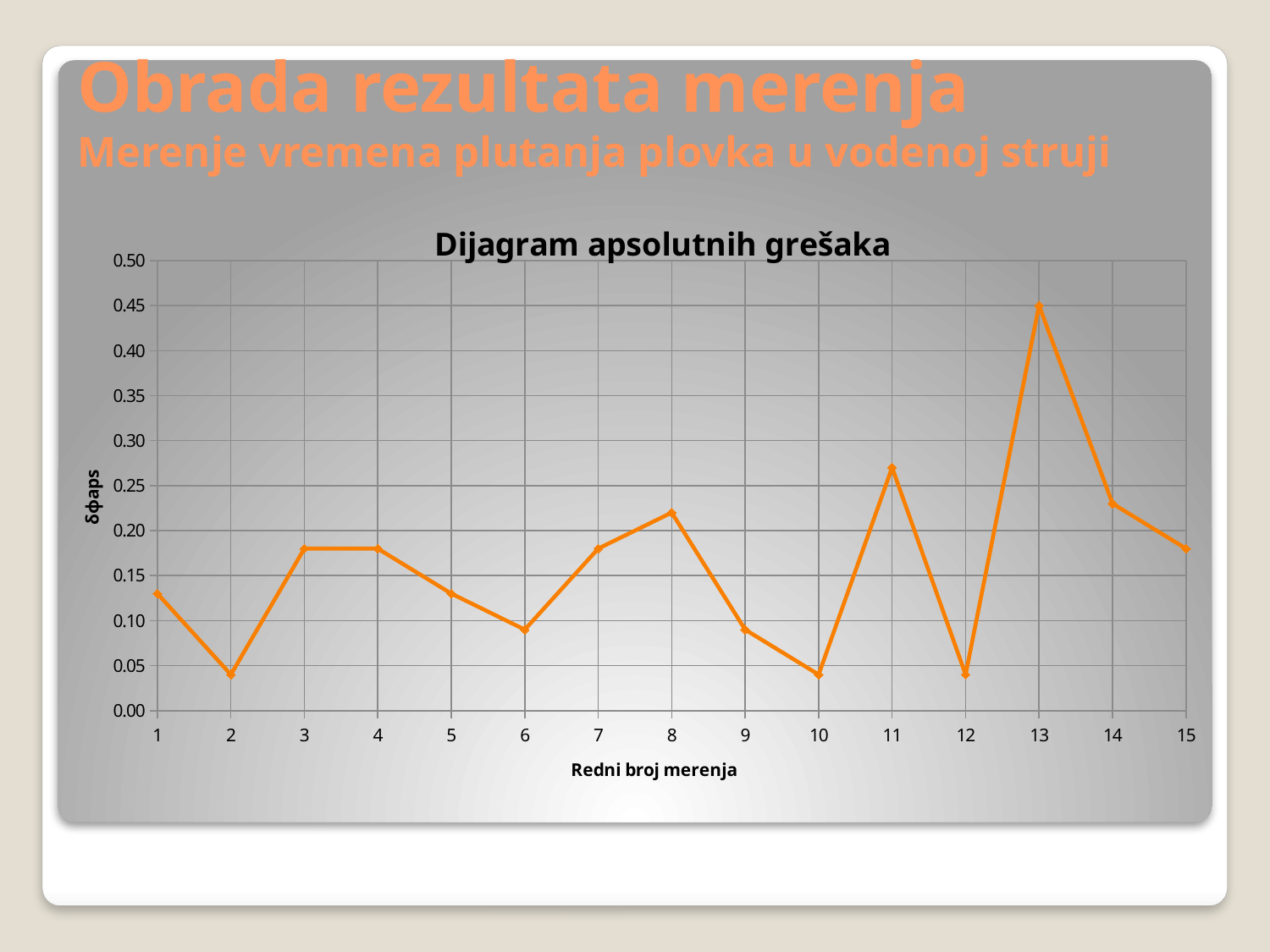
What kind of chart is shown on the slide? line chart Is the value for measurement 2 greater or less than 0.10? less Which has the larger absolute error, measurement 8 or measurement 9? 8 How many measurements (points) are plotted on the x axis? 15 Which has the larger absolute error, measurement 11 or measurement 14? 11 Which measurement number has the highest absolute error? 13 Is the value for measurement 8 greater or less than 0.20? greater Is the value for measurement 13 greater or less than 0.40? greater What is the title of the chart? Dijagram apsolutnih grešaka What is the label of the x axis? Redni broj merenja